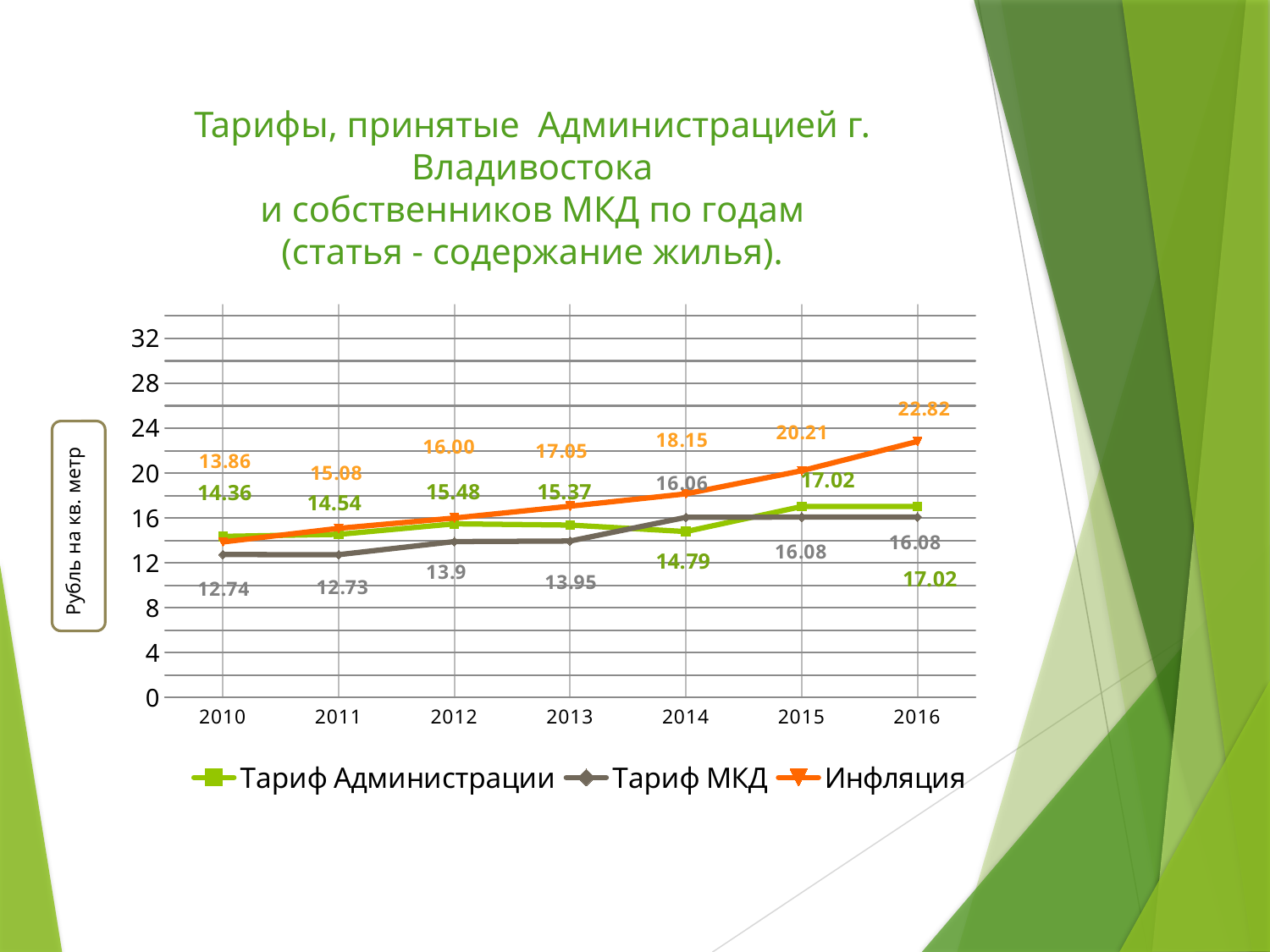
What is the value of Инфляция in 2016? 22.82 Is the value of Инфляция in 2016 greater or less than 24? less In 2014, which is larger: Тариф МКД or Тариф Администрации? Тариф МКД What is the value of Тариф Администрации in 2012? 15.48 How many series does the legend list? 3 What kind of chart is shown on the slide? line chart In which year is Инфляция highest? 2016 How many years are shown on the x axis? 7 By how much did Тариф МКД increase from 2013 to 2014? 2.11 In which year is Инфляция lowest? 2010 What is the difference between Инфляция and Тариф Администрации in 2016? 5.80 What is the value of Тариф МКД in 2010? 12.74